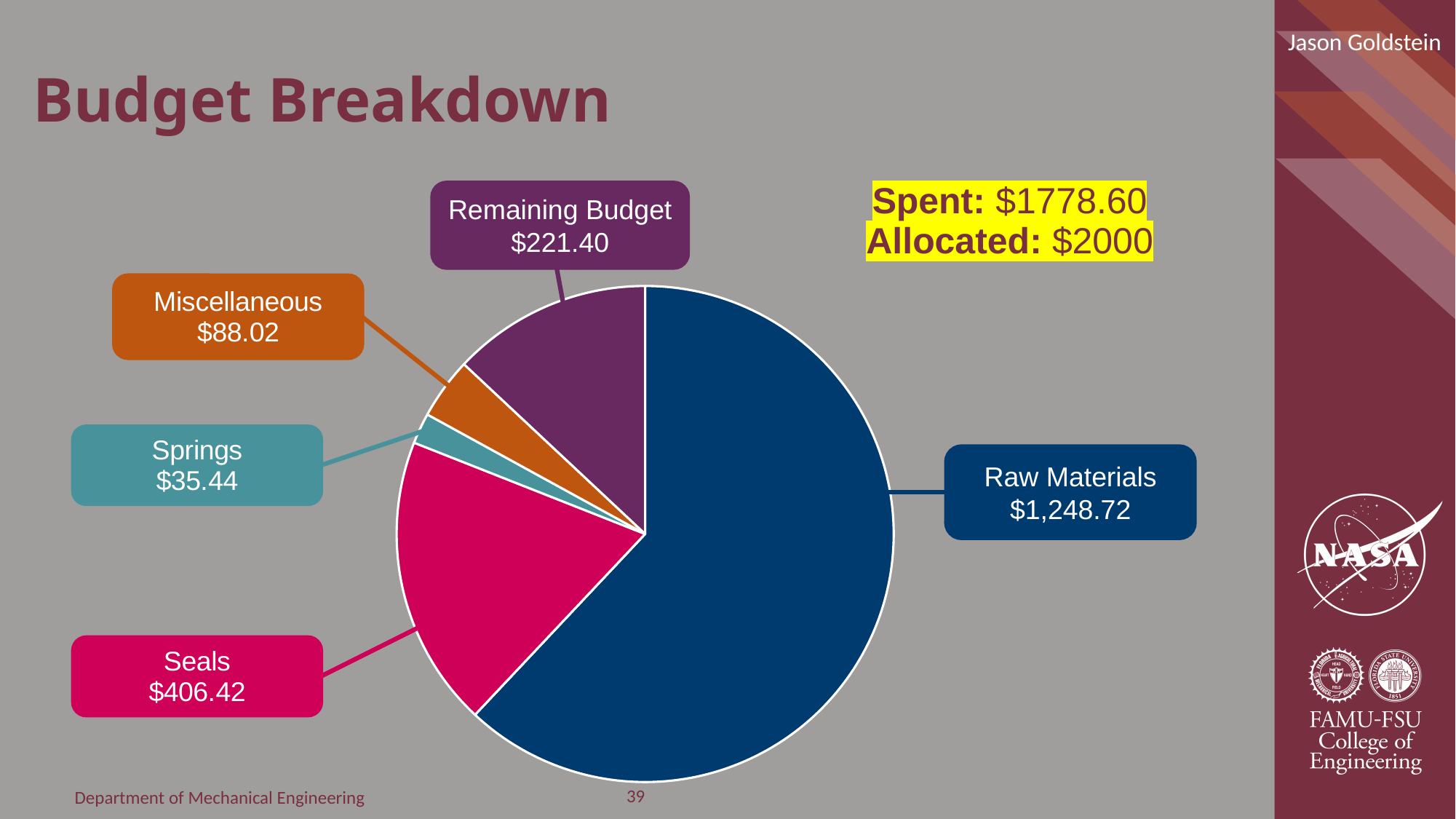
What is the value of the Remaining Budget slice in the pie chart? $221.40 Which category has the smallest slice in the pie chart? Springs What is the difference between the Miscellaneous value and the Springs value? $52.58 What is the title of the slide containing the pie chart? Budget Breakdown How many slices does the pie chart have? 5 Which is larger, the Remaining Budget slice or the Miscellaneous slice? Remaining Budget What is the value of the Raw Materials slice in the pie chart? $1,248.72 What is the value of the Seals slice in the pie chart? $406.42 What is the value of the Springs slice in the pie chart? $35.44 What kind of chart is shown on the slide? Pie chart Which category has the largest slice in the pie chart? Raw Materials What is the difference between the Raw Materials value and the Seals value? $842.30